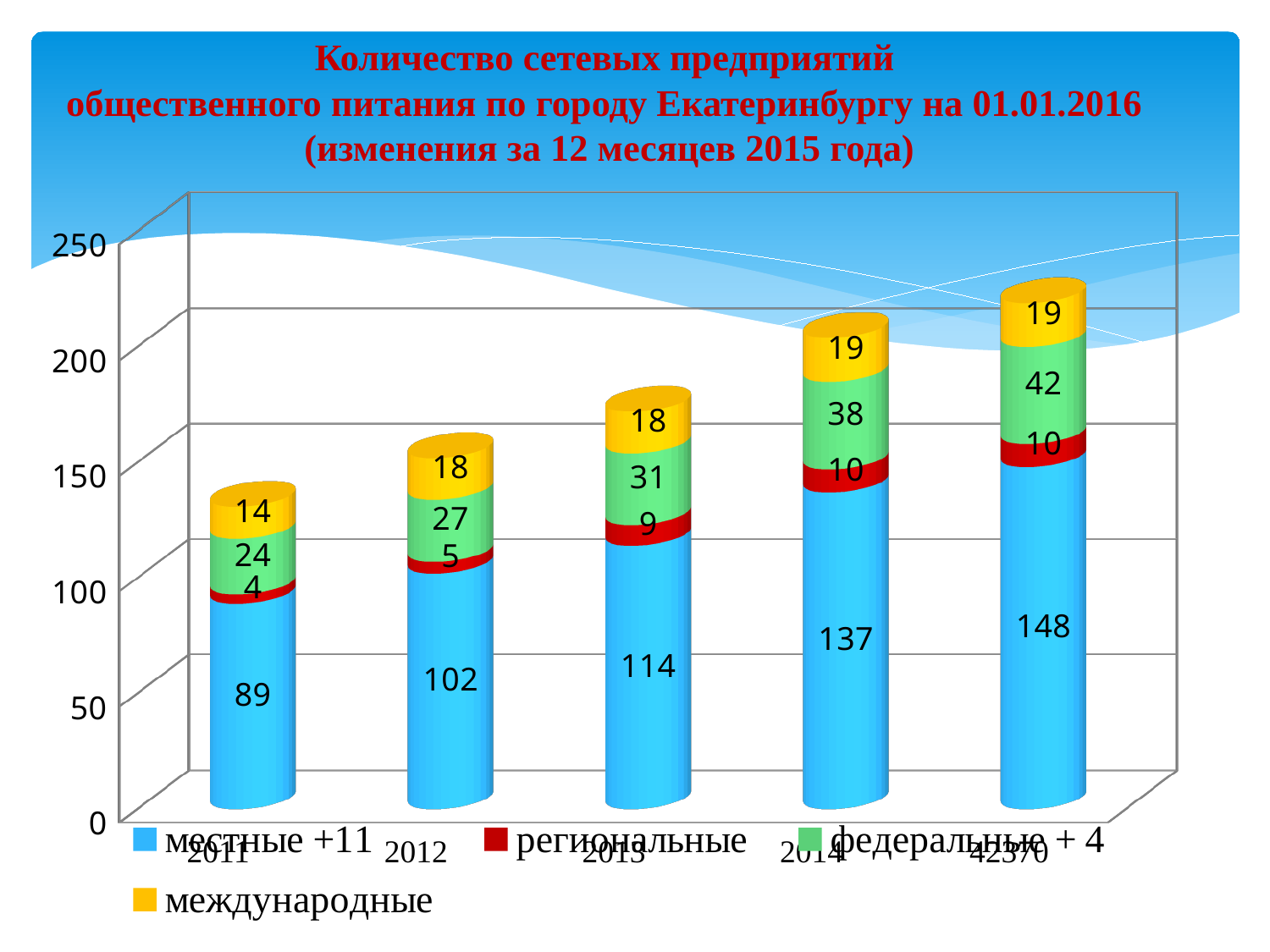
What is the value of the местные series for 2013? 114 How many series does the legend list? 4 Which series is shown in yellow in the legend? международные What is the value of the региональные series for 2012? 5 Which year has the highest value for the местные series? 42370 (the rightmost bar) What is the difference between the местные values for 2014 and 2011? 48 What is the value of the федеральные series for 2014? 38 What type of chart is shown on the slide? stacked bar chart What is the total of the stacked bar for 2012? 152 What is the value of the международные series for 2011? 14 Which year has the lowest value for the федеральные series? 2011 Does the местные series rise or fall from 2011 to the rightmost bar? rise